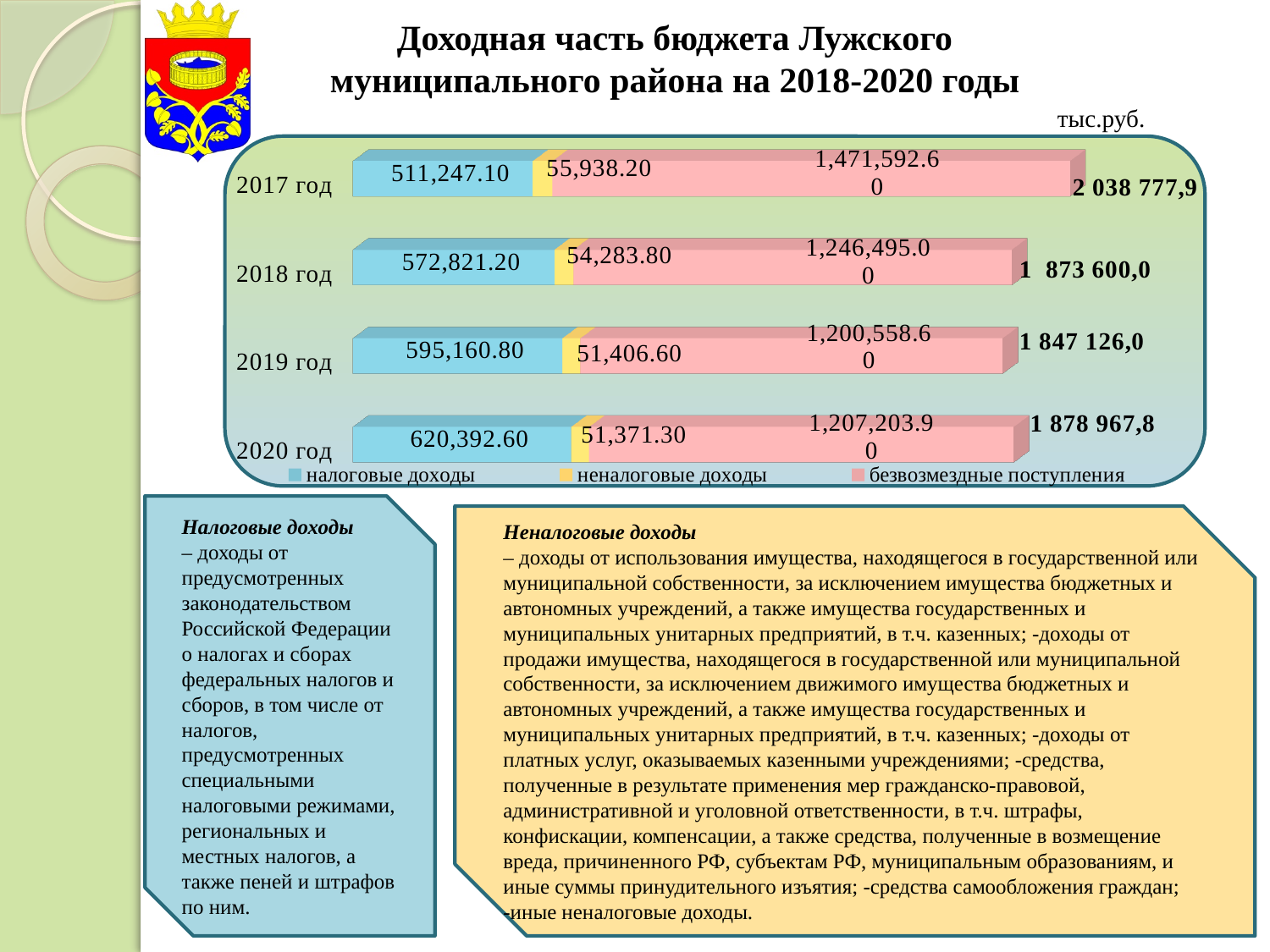
Which year has the highest value of безвозмездные поступления? 2017 год What is the difference between налоговые доходы in 2020 год and in 2017 год? 109,145.50 What kind of chart is shown on the slide? stacked bar chart How many series does the legend list? 3 Which is larger: неналоговые доходы in 2017 год or in 2018 год? 2017 год Do the values of налоговые доходы rise or fall from 2017 год to 2020 год? rise How many years are shown in the chart? 4 What is the value of налоговые доходы for 2017 год? 511,247.10 Which year has the lowest value of налоговые доходы? 2017 год What is the value of безвозмездные поступления for 2020 год? 1,207,203.90 What is the value of неналоговые доходы for 2019 год? 51,406.60 What is the total shown for the 2018 год bar? 1 873 600,0